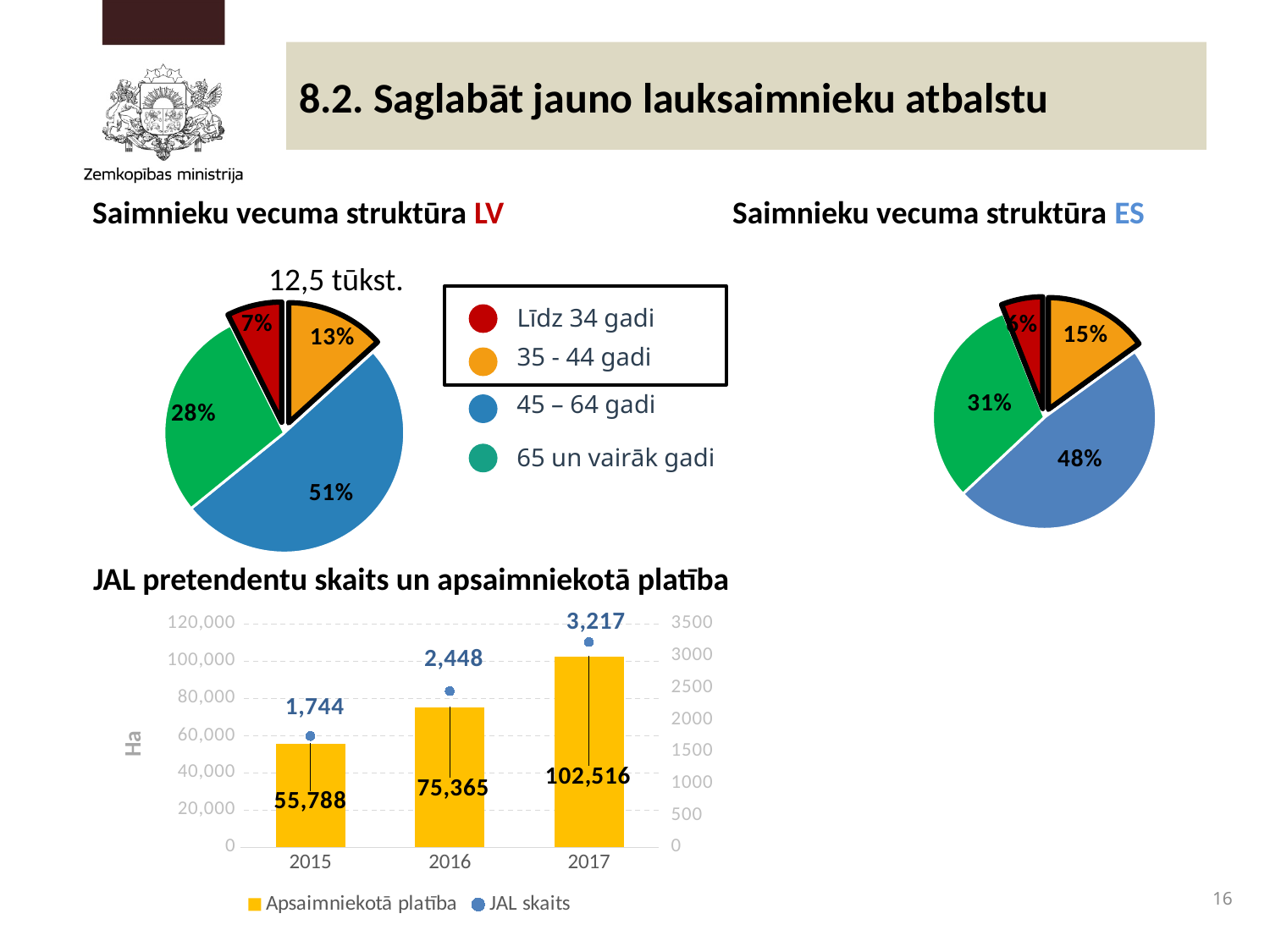
In the 'Saimnieku vecuma struktūra LV' pie chart, what share is the 'Līdz 34 gadi' slice? 7% How many years are shown on the x axis of the 'JAL pretendentu skaits un apsaimniekotā platība' chart? 3 In the 'Saimnieku vecuma struktūra ES' pie chart, which age group has the largest slice? 45 – 64 gadi In the 'JAL pretendentu skaits un apsaimniekotā platība' chart, what is the 'Apsaimniekotā platība' value for 2016? 75,365 In the 'JAL pretendentu skaits un apsaimniekotā platība' chart, what is the 'JAL skaits' value for 2017? 3,217 In the 'Saimnieku vecuma struktūra LV' pie chart, which age group has the smallest slice? Līdz 34 gadi In the 'JAL pretendentu skaits un apsaimniekotā platība' chart, what is the difference in 'Apsaimniekotā platība' between 2017 and 2015? 46,728 How many series does the legend of the 'JAL pretendentu skaits un apsaimniekotā platība' chart list? 2 Comparing the '35 - 44 gadi' slices, which pie chart shows the larger share, LV or ES? ES In the 'Saimnieku vecuma struktūra ES' pie chart, what share is the '65 un vairāk gadi' slice? 31% In the 'Saimnieku vecuma struktūra LV' pie chart, what share is the '45 – 64 gadi' slice? 51% In the 'JAL pretendentu skaits un apsaimniekotā platība' chart, does 'JAL skaits' rise or fall from 2015 to 2017? rise